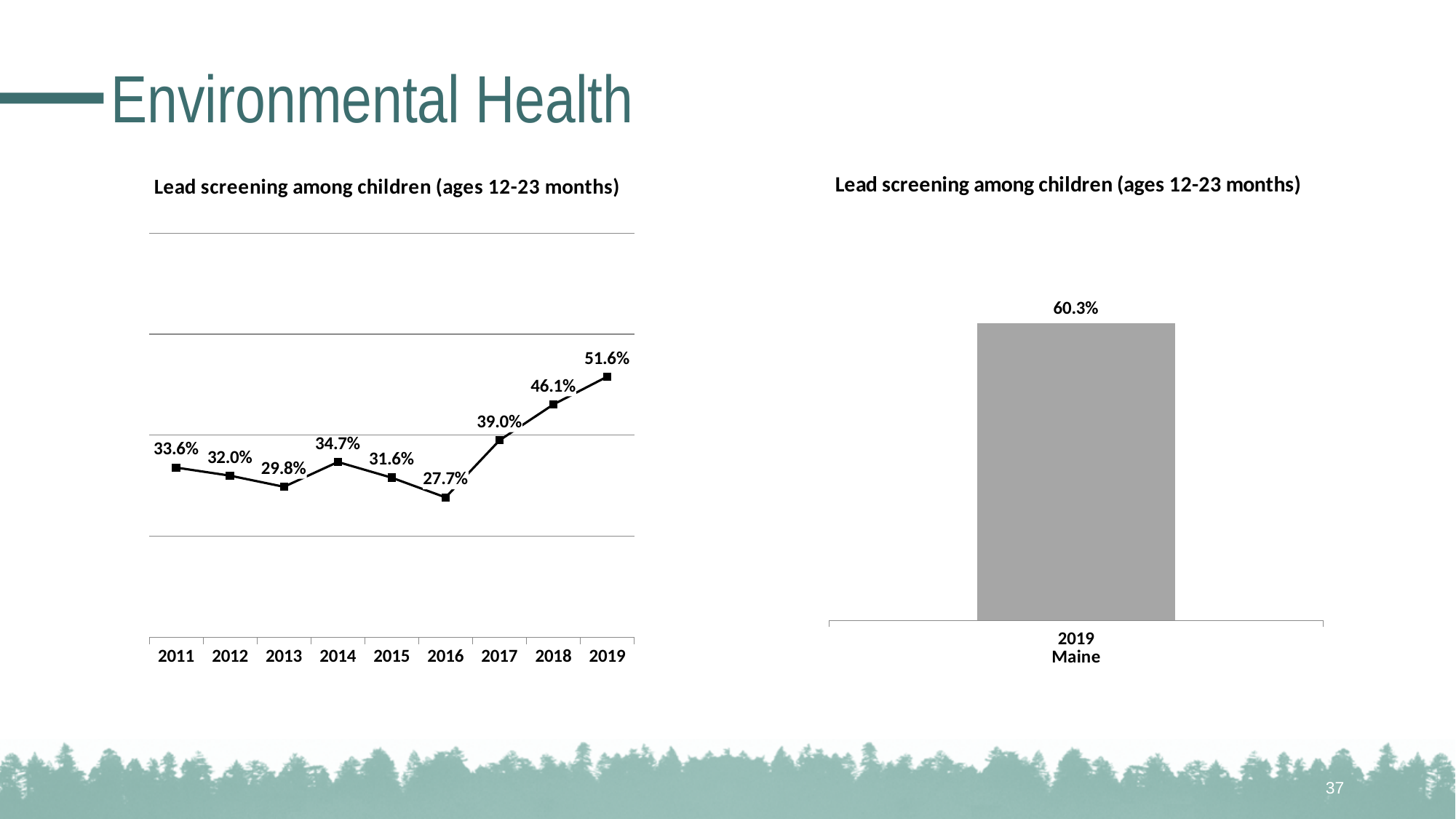
In the right-hand bar chart, what is the 2019 lead screening rate for Maine? 60.3% What kind of chart is the right-hand chart on the slide? Bar chart In the left-hand line chart, which year has the lowest lead screening rate? 2016 What kind of chart is the left-hand chart on the slide? Line chart In the left-hand line chart, what is the difference between the 2019 and 2011 lead screening rates? 18.0% What is the title of the right-hand chart? Lead screening among children (ages 12-23 months) In the left-hand line chart, what was the lead screening rate among children in 2019? 51.6% In the left-hand line chart, what was the lead screening rate among children in 2016? 27.7% In the left-hand line chart, do the lead screening rates rise or fall from 2016 to 2019? Rise How many years are plotted in the left-hand line chart? 9 In the left-hand line chart, which year has a higher lead screening rate, 2014 or 2015? 2014 In the left-hand line chart, which year has the highest lead screening rate? 2019